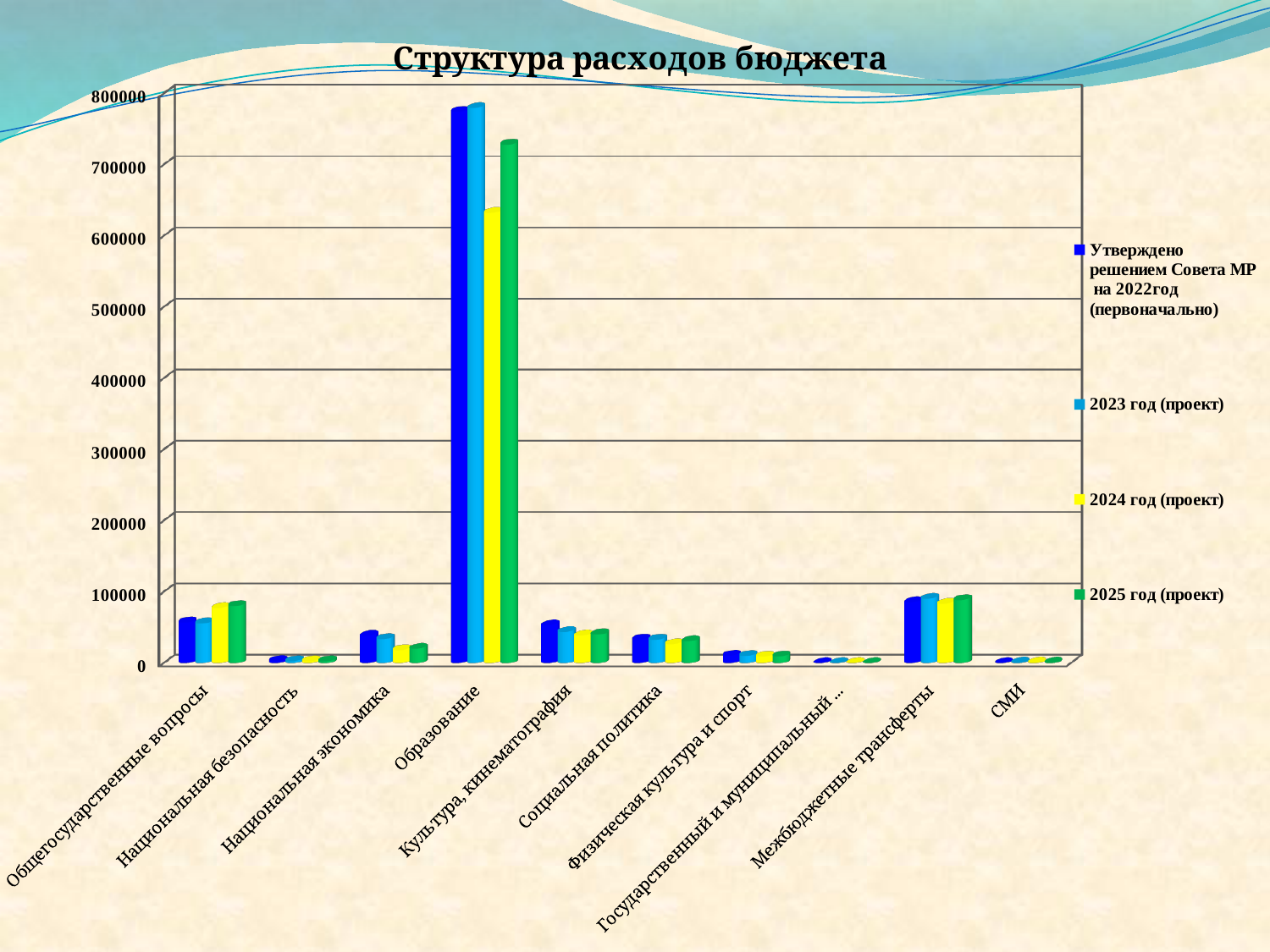
Is the value for Образование in the series 'Утверждено решением Совета МР на 2022год (первоначально)' greater or less than 700000? greater For Образование, which series has the lowest value? 2024 год (проект) Which category has the highest values in the chart? Образование How many series does the legend list? 4 Is the value for Межбюджетные трансферты in the series '2023 год (проект)' greater or less than 100000? less Is the value for Образование in the series '2024 год (проект)' greater or less than 700000? less What is the title of the chart? Структура расходов бюджета For Образование, which is larger: the value for '2023 год (проект)' or the value for '2024 год (проект)'? 2023 год (проект) Which colour represents the series '2025 год (проект)' in the legend? green How many categories are shown on the x axis? 10 What kind of chart is shown on the slide? bar chart